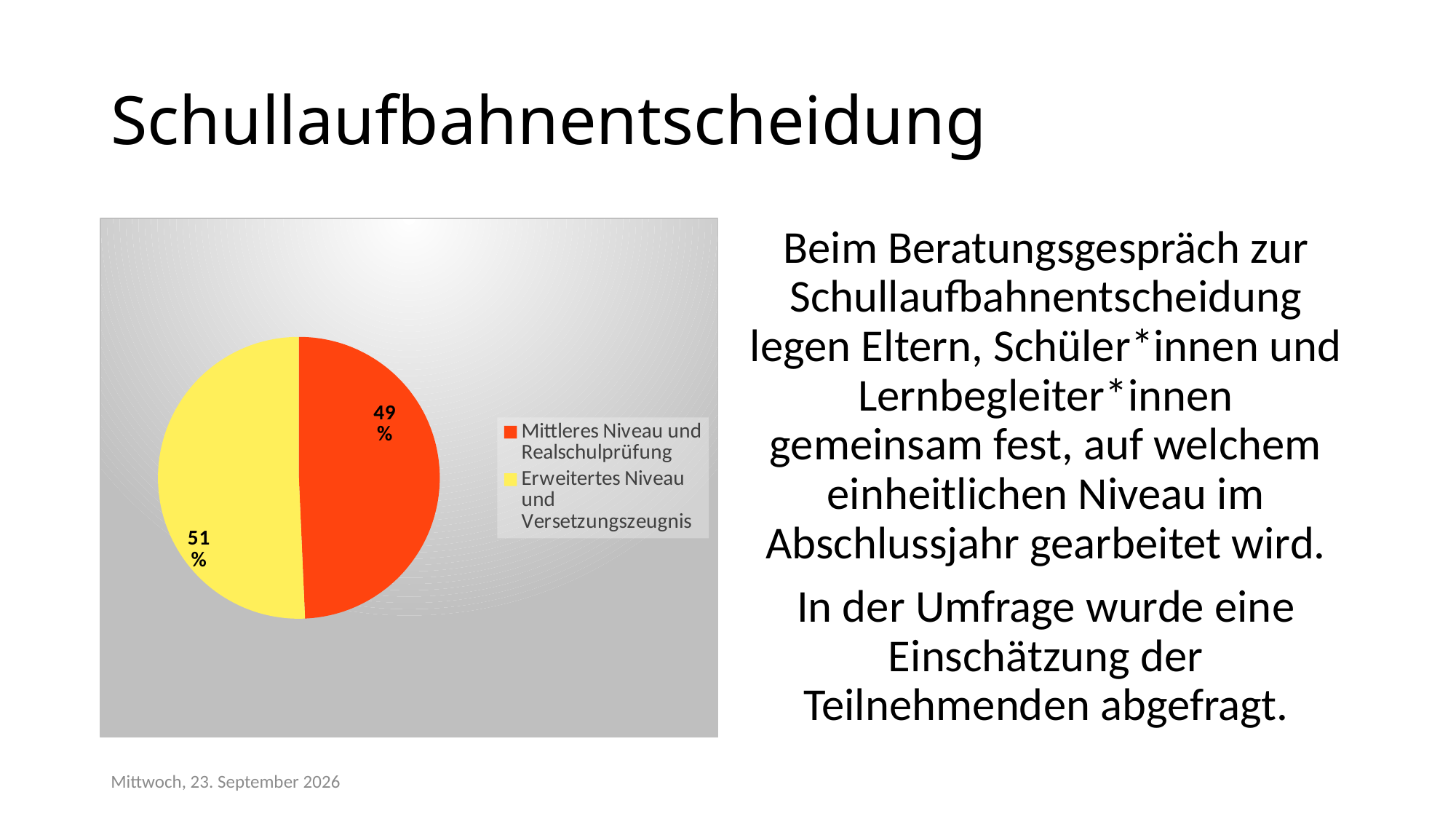
Which slice of the pie is the largest? Erweitertes Niveau und Versetzungszeugnis What share of the pie is labelled "Mittleres Niveau und Realschulprüfung"? 49% How many entries does the legend of the pie chart list? 2 Is the share for "Mittleres Niveau und Realschulprüfung" greater or less than 50%? less Which slice of the pie is the smallest? Mittleres Niveau und Realschulprüfung What colour is the slice for "Erweitertes Niveau und Versetzungszeugnis"? yellow What kind of chart is shown on the slide? pie chart What colour is the slice for "Mittleres Niveau und Realschulprüfung"? red What share of the pie is labelled "Erweitertes Niveau und Versetzungszeugnis"? 51% Which is larger: the share for "Mittleres Niveau und Realschulprüfung" or the share for "Erweitertes Niveau und Versetzungszeugnis"? Erweitertes Niveau und Versetzungszeugnis What is the difference in percentage points between the "Erweitertes Niveau und Versetzungszeugnis" slice and the "Mittleres Niveau und Realschulprüfung" slice? 2 How many slices does the pie chart have? 2